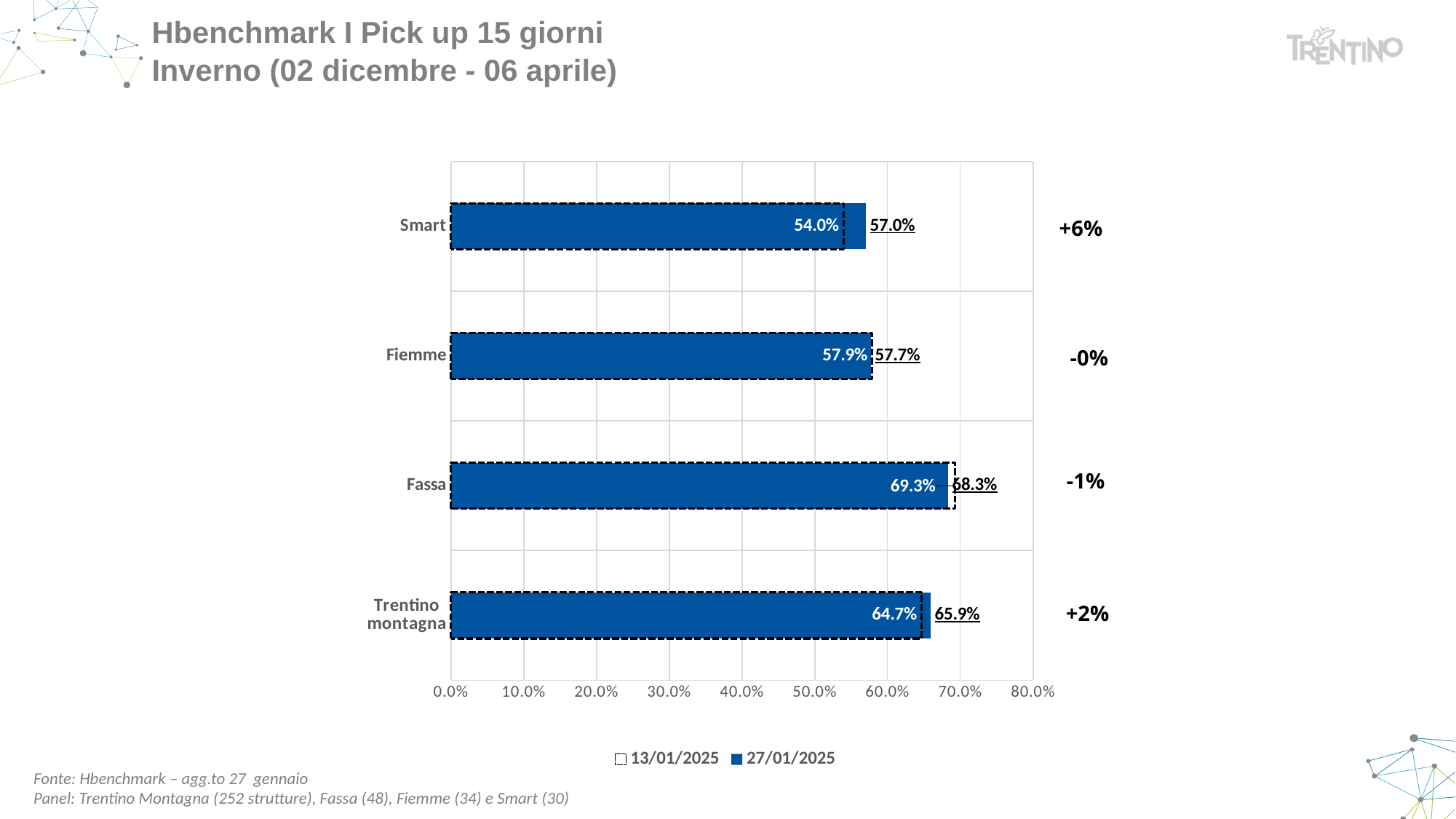
What percentage change is shown to the right of the Smart bars? +6% Which category has the highest value in the 27/01/2025 series? Fassa What is the value for Fassa in the 13/01/2025 series? 69.3% What is the value for Trentino montagna in the 27/01/2025 series? 65.9% Which is larger for Trentino montagna: the 13/01/2025 value or the 27/01/2025 value? 27/01/2025 How many categories are shown on the chart? 4 What is the difference between the 27/01/2025 and 13/01/2025 values for Smart? 3.0% How many series does the legend list? 2 Which category has the lowest value in the 13/01/2025 series? Smart Is the 27/01/2025 value for Fassa greater or less than 60.0%? greater What is the value for Smart in the 27/01/2025 series? 57.0% What is the value for Fiemme in the 13/01/2025 series? 57.9%